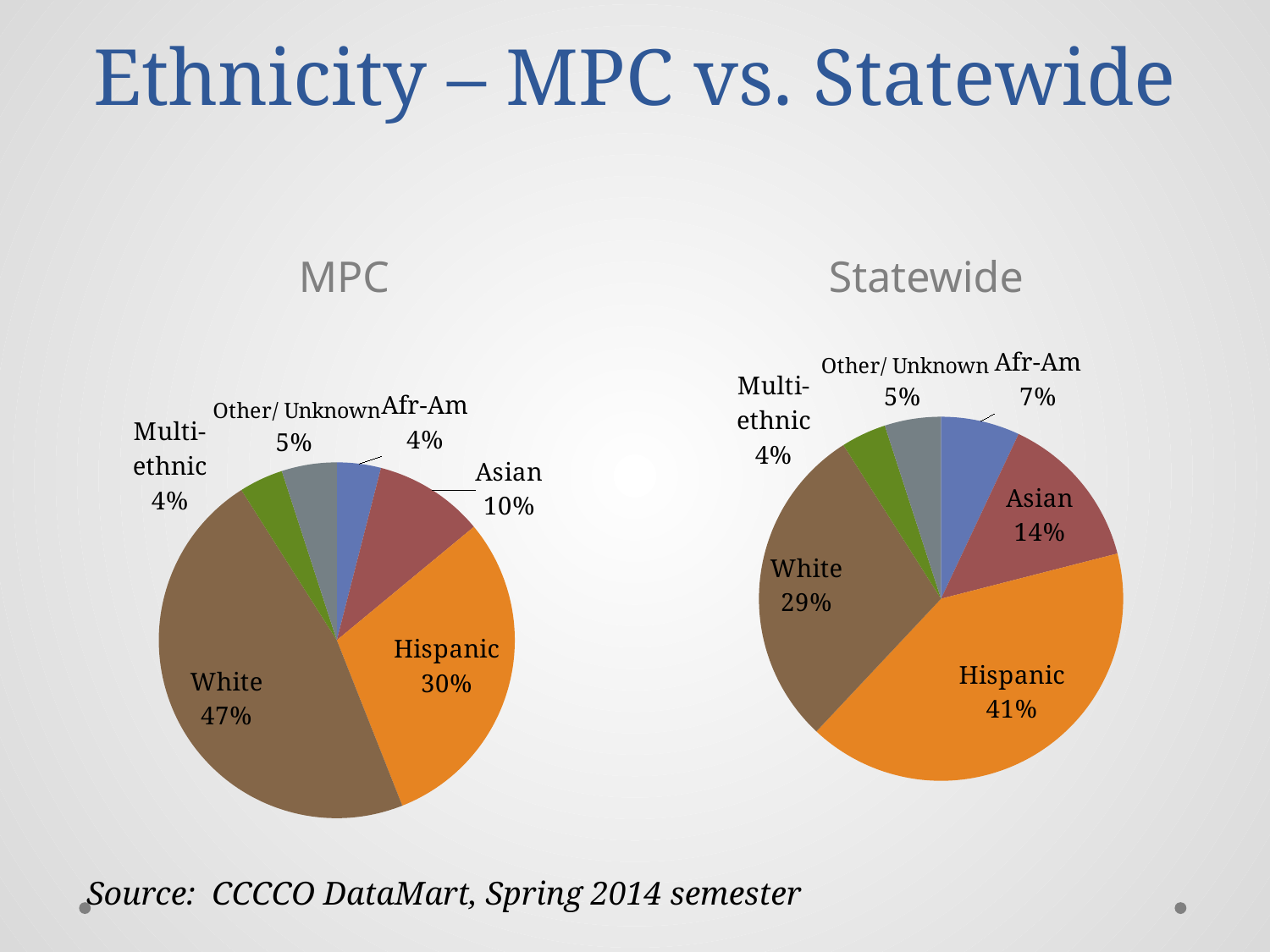
In the MPC chart, which ethnicity has the largest share? White In the Statewide chart, which ethnicity has the smallest share? Multi-ethnic What is the difference between the White share in the MPC chart and the White share in the Statewide chart? 18% In the MPC chart, what is the value for Afr-Am? 4% In the MPC chart, what share of students is White? 47% What kind of chart is the Statewide chart? Pie chart Which is larger: the Hispanic share in the MPC chart or the Hispanic share in the Statewide chart? Statewide In the Statewide chart, what share of students is Hispanic? 41% How many categories does the MPC pie chart show? 6 In the Statewide chart, which ethnicity has the largest share? Hispanic What is the title of the slide? Ethnicity – MPC vs. Statewide In the Statewide chart, what is the value for Asian? 14%